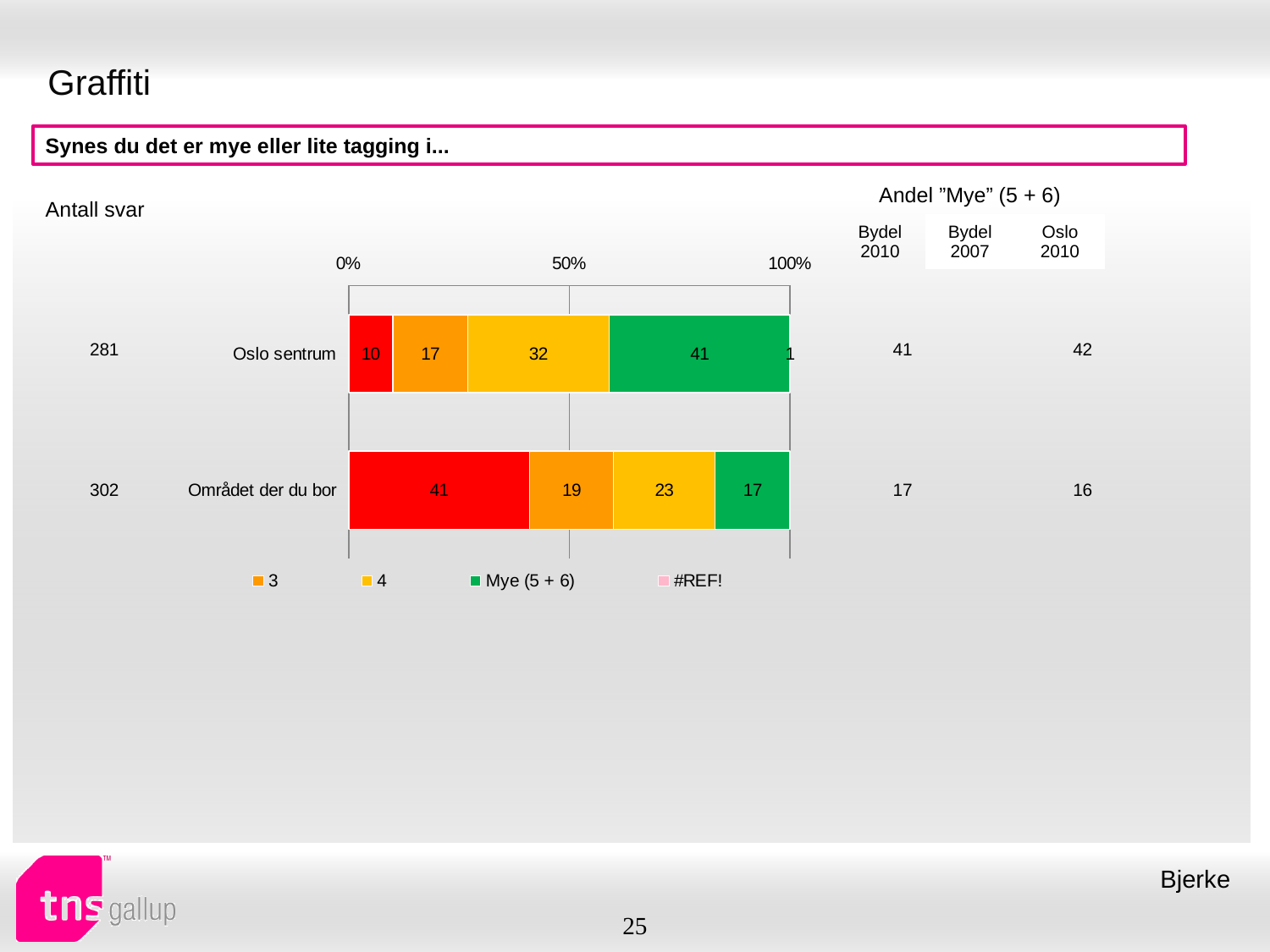
What is the value of the "Mye (5 + 6)" segment for Området der du bor? 17 Which category has the larger "Mye (5 + 6)" value, Oslo sentrum or Området der du bor? Oslo sentrum What is the difference between the "Mye (5 + 6)" values for Oslo sentrum and Området der du bor? 24 What is the value of the "3" segment for Området der du bor? 19 What is the value of the "4" segment for Oslo sentrum? 32 What is the difference between the "4" values for Oslo sentrum and Området der du bor? 9 What is the value of the "Mye (5 + 6)" segment for Oslo sentrum? 41 What kind of chart is shown on the slide? Stacked bar chart How many entries does the chart legend list? 4 What is the value of the "4" segment for Området der du bor? 23 What is the value of the "3" segment for Oslo sentrum? 17 How many categories are shown on the chart? 2